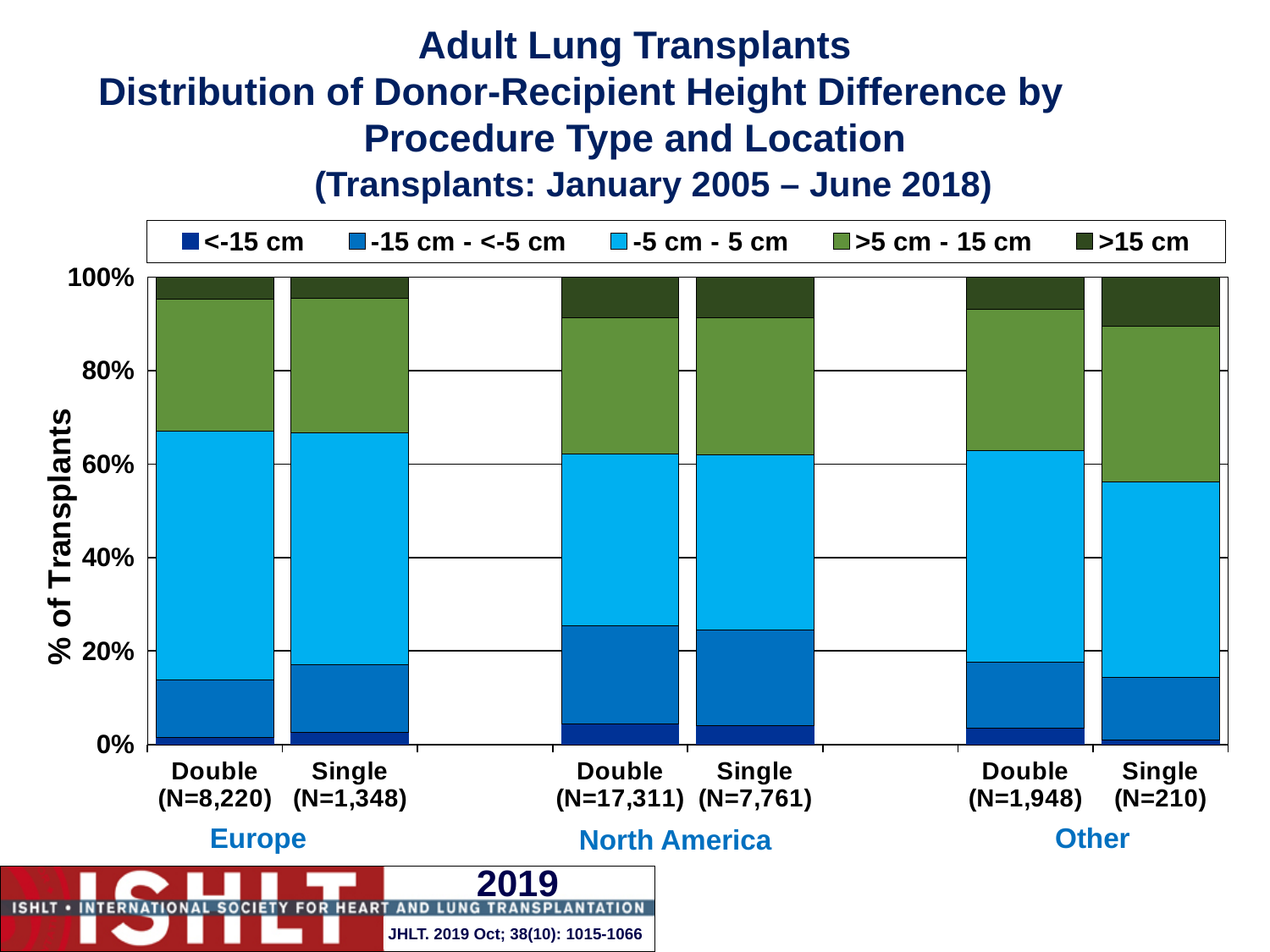
How many bars are plotted in the chart? 6 What kind of chart is shown on the slide? Stacked bar chart Which bar has the smallest N? Single (N=210) in Other What is the label of the y-axis? % of Transplants What is the N value shown for the Single bar in North America? N=7,761 What is the N value shown for the Double bar in Europe? N=8,220 How many series does the legend list? 5 Is the '-15 cm - <-5 cm' segment larger for the North America Double bar or the Europe Double bar? North America Double What is the N value shown for the Single bar in Other? N=210 Is the '>15 cm' segment larger for the Other Single bar or the Europe Single bar? Other Single What does each stacked bar total? 100% Which location group has the largest N for Double transplants? North America (N=17,311)